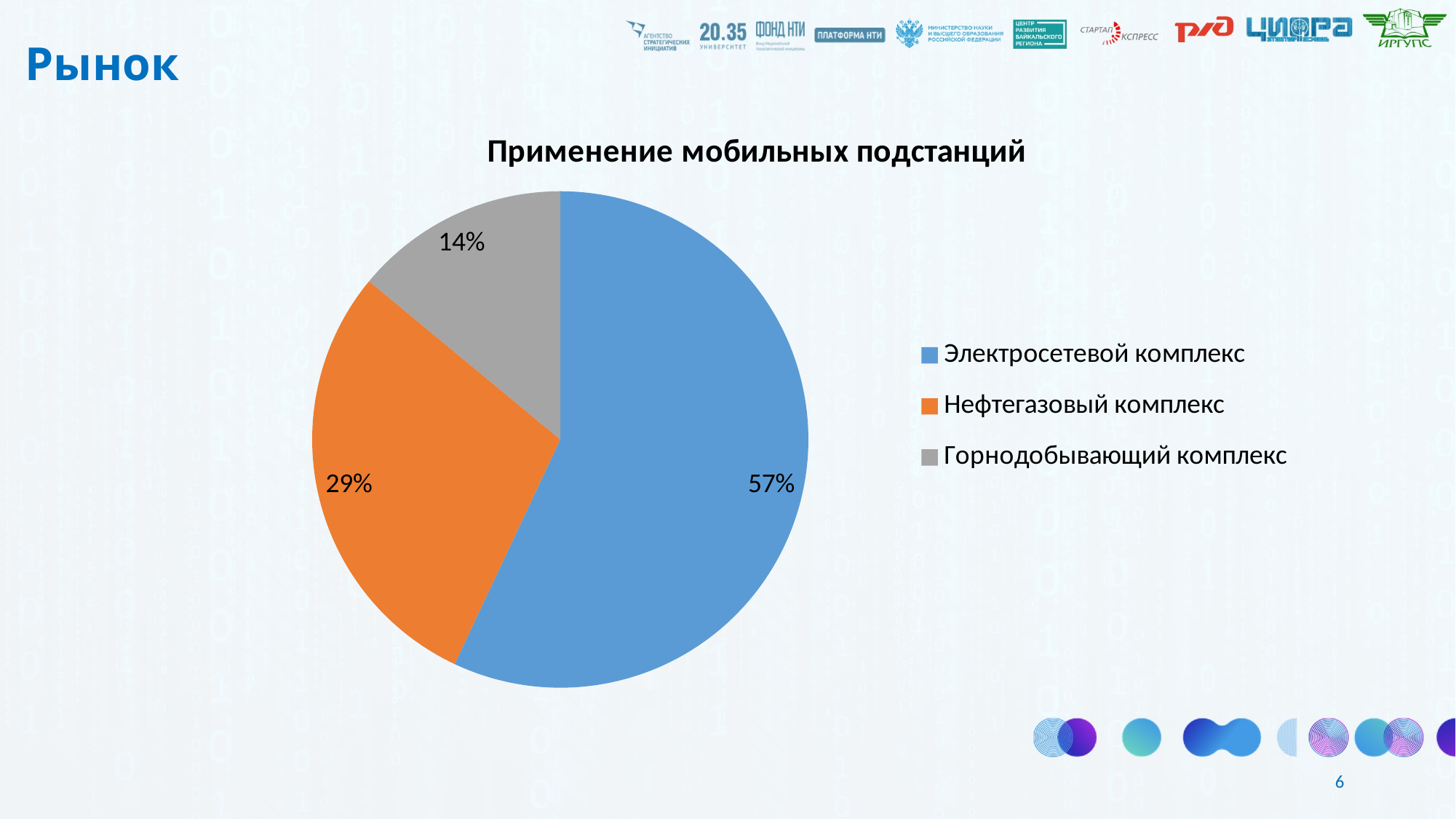
What share of the pie does Горнодобывающий комплекс have? 14% What colour is the slice for Нефтегазовый комплекс? orange Which is larger: the share for Нефтегазовый комплекс or the share for Горнодобывающий комплекс? Нефтегазовый комплекс Which category has the largest slice of the pie? Электросетевой комплекс How many categories are shown in the pie chart? 3 What share of the pie does Нефтегазовый комплекс have? 29% What share of the pie does Электросетевой комплекс have? 57% What kind of chart is shown on the slide? pie chart What is the title of the chart? Применение мобильных подстанций What is the difference in percentage points between Нефтегазовый комплекс and Горнодобывающий комплекс? 15 Which category has the smallest slice of the pie? Горнодобывающий комплекс What is the difference in percentage points between Электросетевой комплекс and Нефтегазовый комплекс? 28